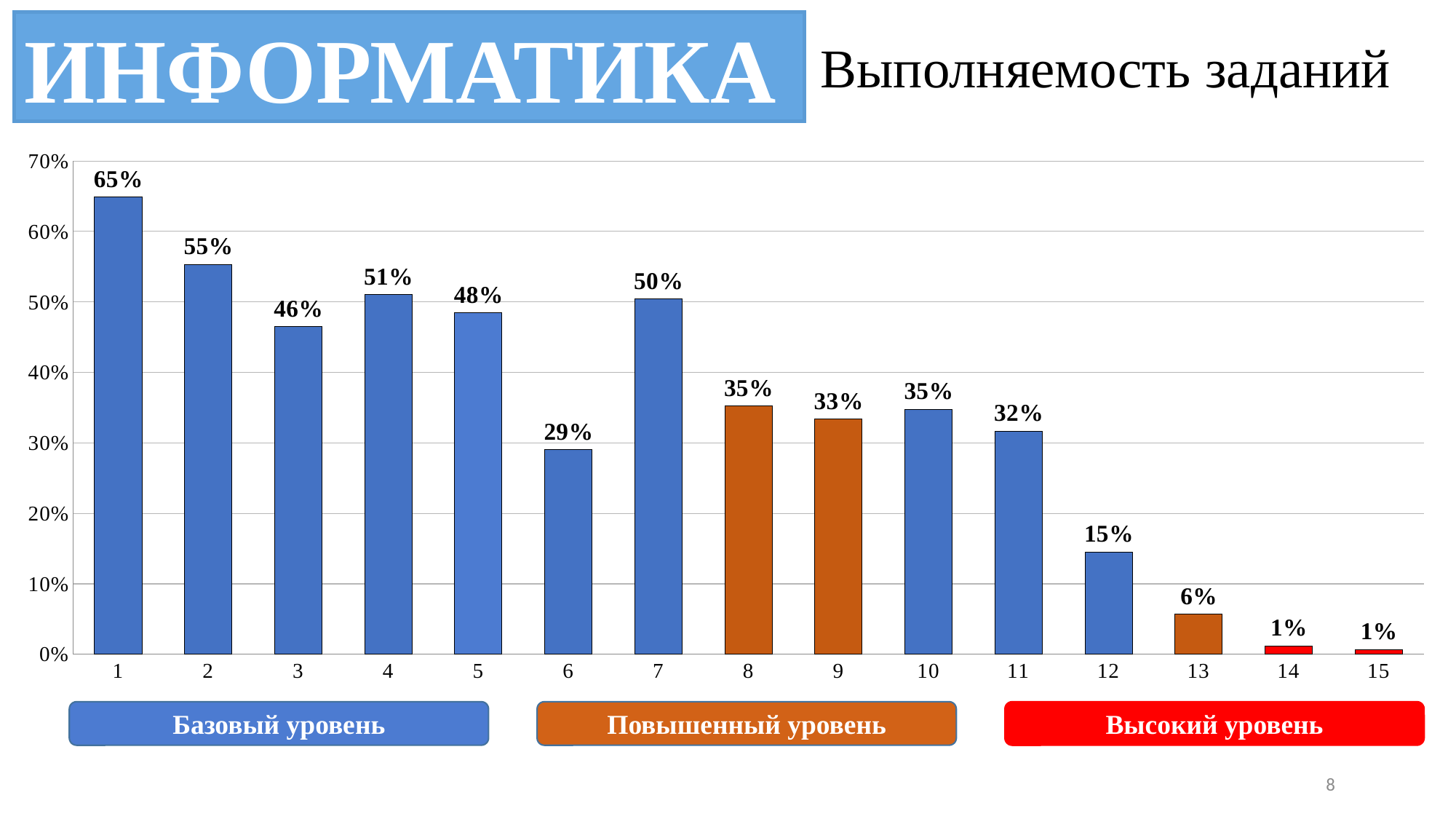
Which is larger, the value for task 4 or the value for task 5? task 4 What is the value for task 1? 65% What is the difference between the values for task 1 and task 2? 10% What is the difference between the values for task 7 and task 6? 21% Which task has the lowest value among tasks 1 to 13? 13 What is the value for task 6? 29% How many tasks are shown on the x axis? 15 What is the value for task 9? 33% What colour are the bars for tasks 14 and 15? red What is the value for task 12? 15% What kind of chart is shown on the slide? bar chart Which task has the highest value? 1